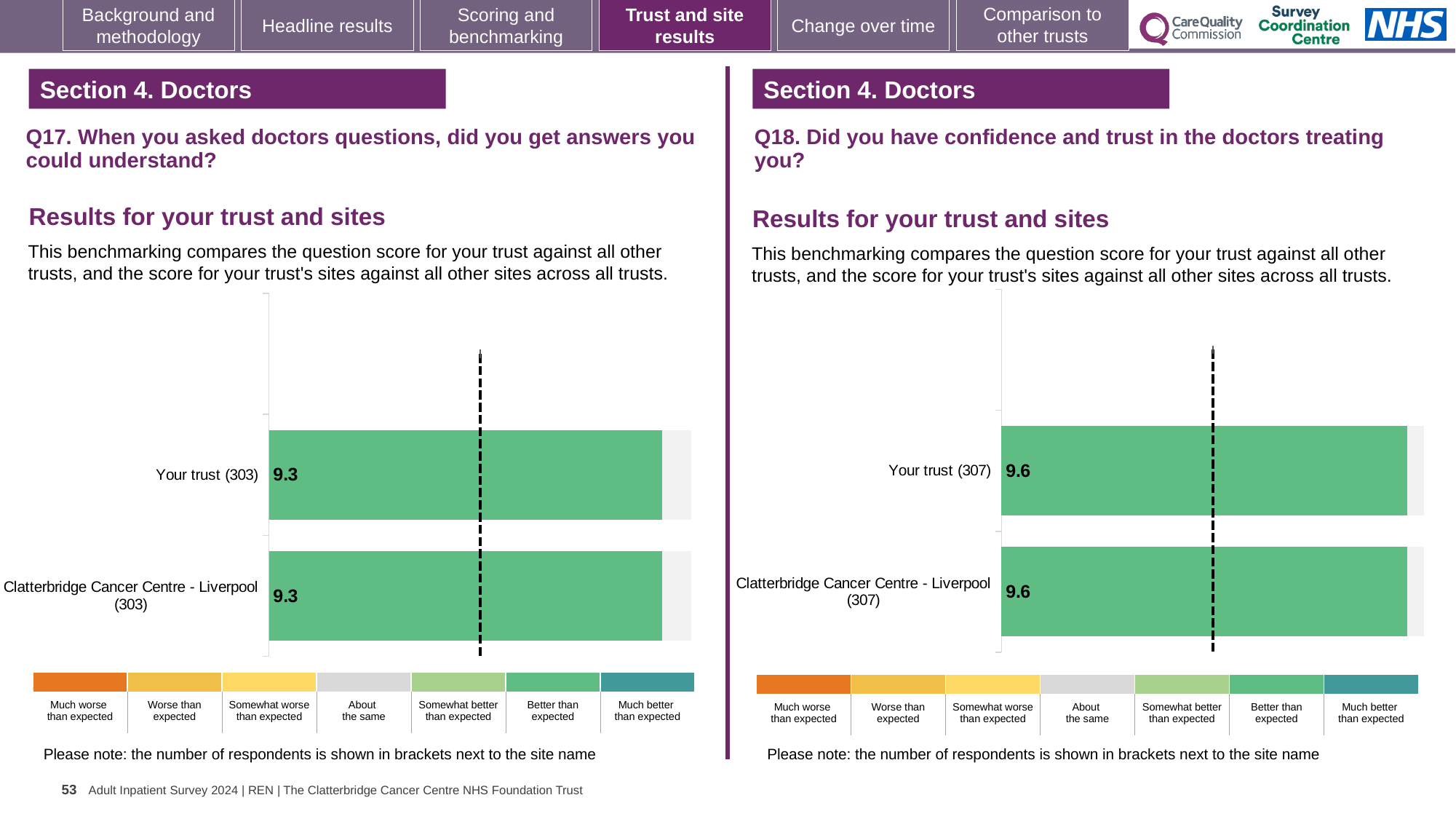
On the Q18 chart (right), what is the score for Clatterbridge Cancer Centre - Liverpool? 9.6 Is the score for Your trust on the Q18 chart (right) larger than the score for Your trust on the Q17 chart (left)? Yes On the Q18 chart (right), what is the difference between the score for Your trust and the score for Clatterbridge Cancer Centre - Liverpool? 0 On the Q17 chart (left), what is the score for Clatterbridge Cancer Centre - Liverpool? 9.3 What kind of chart is the Q18 chart (right)? Bar chart On the Q17 chart (left), what is the score for Your trust? 9.3 On the Q17 chart (left), how many respondents are shown in brackets next to Your trust? 303 On the Q18 chart (right), how many respondents are shown in brackets next to Clatterbridge Cancer Centre - Liverpool? 307 How many bars are plotted on the Q18 chart (right)? 2 On the Q17 chart (left), what is the difference between the score for Your trust and the score for Clatterbridge Cancer Centre - Liverpool? 0 On the Q18 chart (right), what is the score for Your trust? 9.6 How many bars are plotted on the Q17 chart (left)? 2